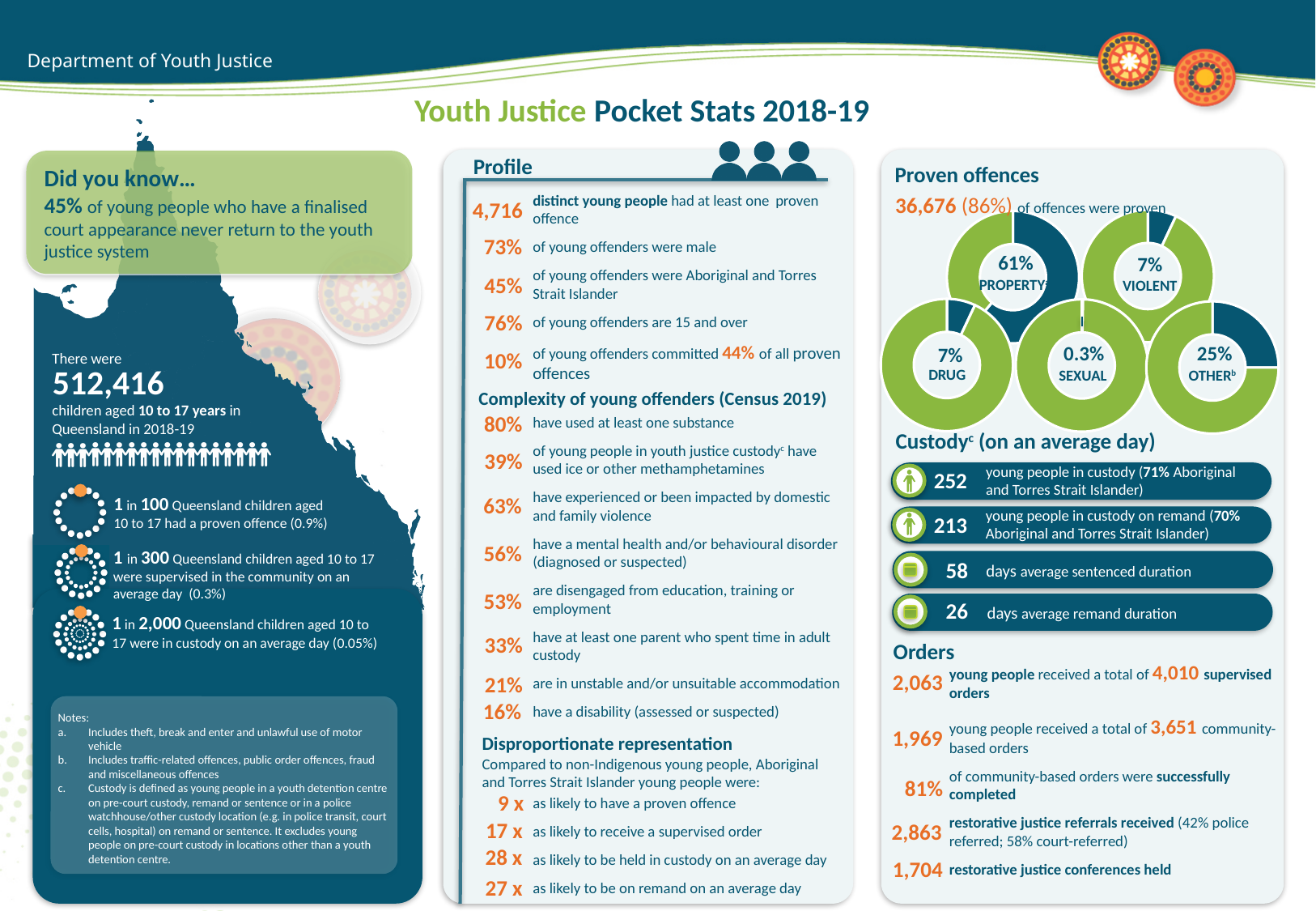
In the Proven offences donut charts, what percentage of proven offences were drug offences? 7% What kind of chart is used to show the Proven offences breakdown? Donut (pie) chart How many offence categories are shown in the Proven offences donut charts? 5 In the Proven offences donut charts, what percentage of proven offences were property offences? 61% In the Proven offences donut charts, which is larger: the share for other offences or the share for violent offences? Other In the Proven offences donut charts, what percentage of proven offences were classed as other? 25% In the Proven offences donut charts, which offence category has the highest share? Property In the Proven offences section, how many offences were proven in total? 36,676 In the Proven offences donut charts, what percentage of proven offences were violent offences? 7% In the Proven offences donut charts, which offence category has the lowest share? Sexual In the Proven offences donut charts, what percentage of proven offences were sexual offences? 0.3% In the Proven offences donut charts, what is the difference in percentage points between property offences and other offences? 36